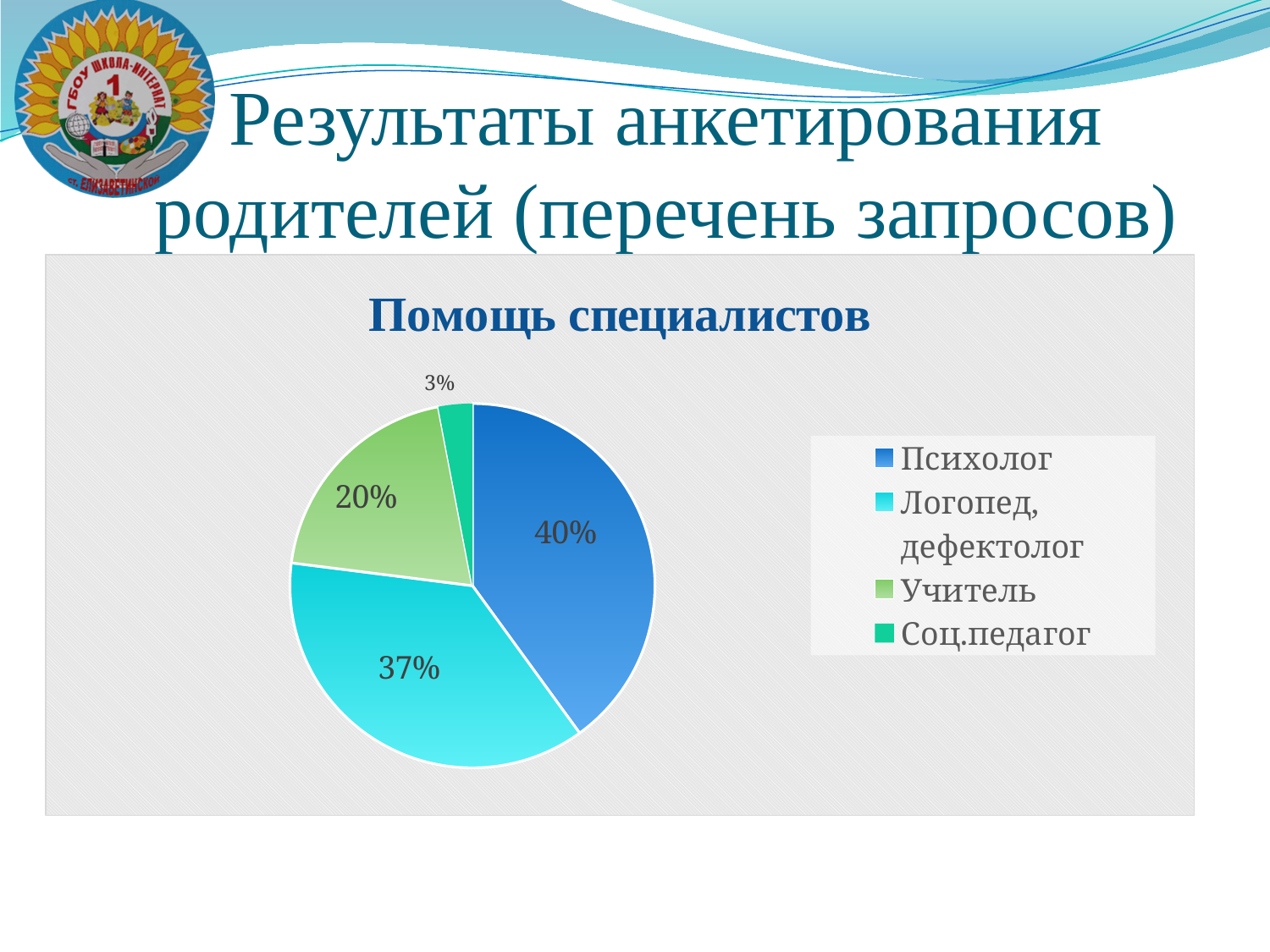
How many categories does the legend list? 4 What is the difference between the shares of Психолог and Логопед, дефектолог? 3% What share of the pie does Соц.педагог have? 3% What type of chart is shown on the slide? pie chart What share of the pie does Логопед, дефектолог have? 37% What is the difference between the shares of Учитель and Соц.педагог? 17% Which category has the largest share of the pie? Психолог What share of the pie does Учитель have? 20% Which category has the smallest share of the pie? Соц.педагог What is the title of the chart? Помощь специалистов Which is larger, the share for Учитель or the share for Соц.педагог? Учитель